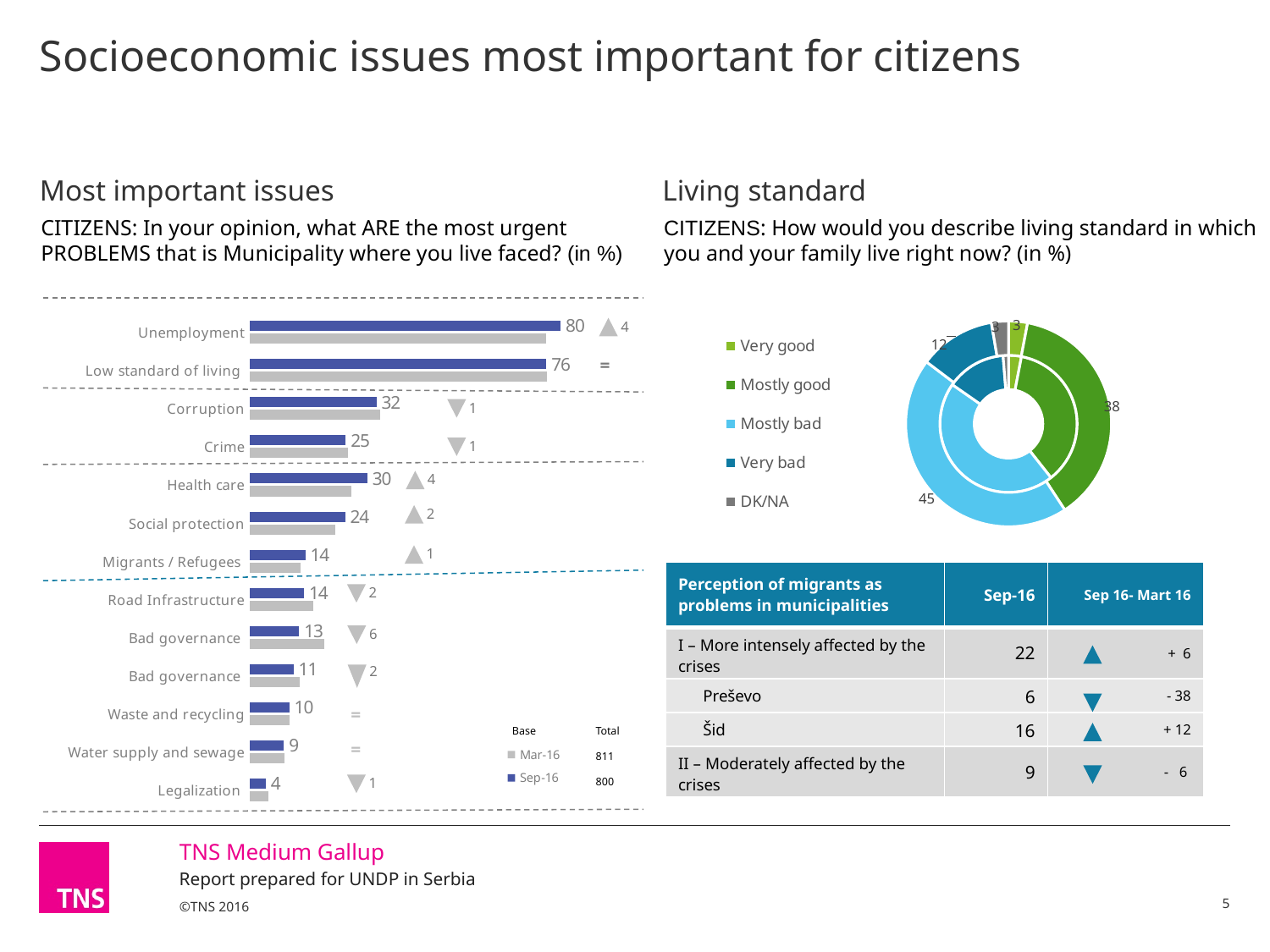
In the Most important issues chart, which has a higher Sep-16 value, Health care or Crime? Health care In the Most important issues chart, which issue has the highest Sep-16 value? Unemployment In the Living standard chart, what is the value for Mostly bad? 45 In the Most important issues chart, what is the Sep-16 value for Corruption? 32 In the Living standard chart, which category has the largest share? Mostly bad What kind of chart is the Most important issues chart? Bar chart How many series does the legend of the Most important issues chart list? 2 How many categories does the legend of the Living standard chart list? 5 In the Most important issues chart, what is the difference between the Sep-16 values for Unemployment and Low standard of living? 4 How many issue categories are shown in the Most important issues chart? 13 In the Most important issues chart, which issue has the lowest Sep-16 value? Legalization In the Most important issues chart, what is the Sep-16 value for Unemployment? 80